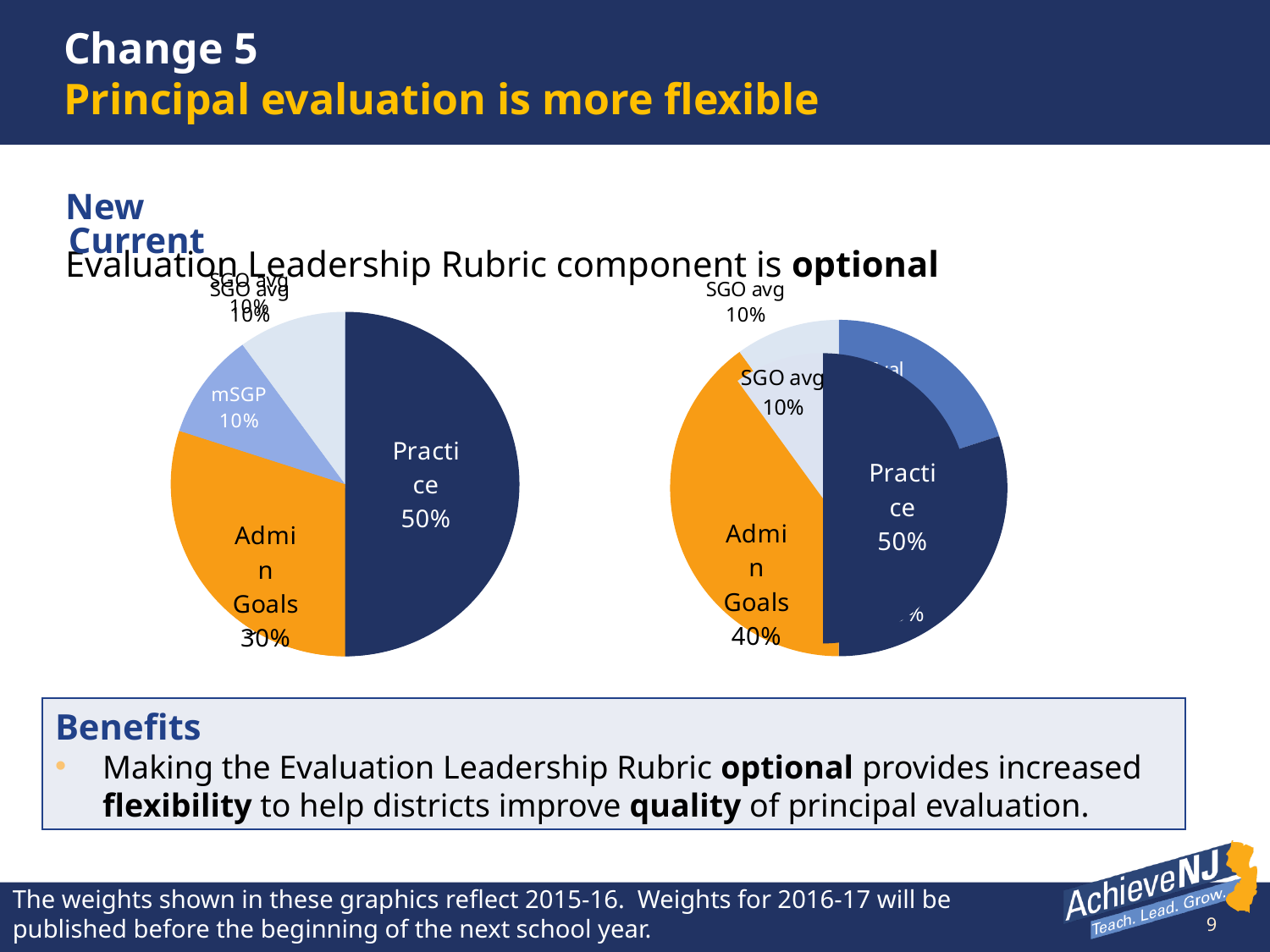
In the right pie chart, what percentage is shown for SGO avg? 10% In the left pie chart, what percentage is shown for Admin Goals? 30% In the right pie chart, what percentage is shown for Practice? 50% Which chart shows a larger share for Admin Goals, the left pie chart or the right pie chart? The right pie chart What type of chart is used on this slide? Pie chart In the left pie chart, what is the difference between the Practice share and the Admin Goals share? 20% In the left pie chart, which is larger, Practice or Admin Goals? Practice In the right pie chart, which component has the largest share? Practice In the left pie chart, what percentage is shown for Practice? 50% In the right pie chart, what percentage is shown for Admin Goals? 40% In the left pie chart, which component has the largest share? Practice In the left pie chart, what percentage is shown for mSGP? 10%